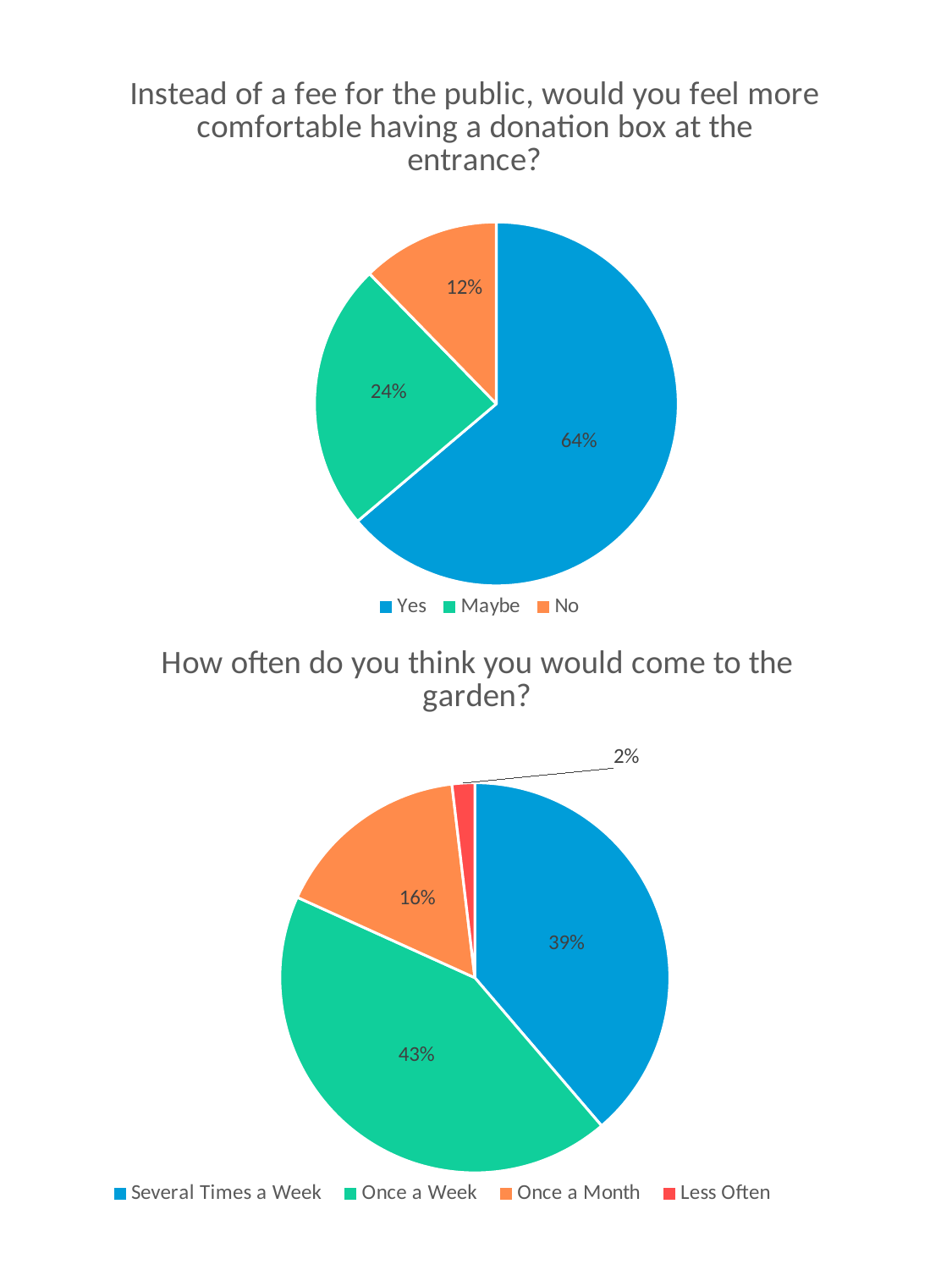
In the top chart about a donation box at the entrance, what is the difference between the Maybe and No shares? 12% In the bottom chart about how often people would come to the garden, what is the difference between the Once a Week and Several Times a Week shares? 4% In the top chart about a donation box at the entrance, what share of respondents answered Yes? 64% In the bottom chart about how often people would come to the garden, which is larger: Several Times a Week or Once a Month? Several Times a Week In the bottom chart about how often people would come to the garden, what share chose Once a Week? 43% In the top chart about a donation box at the entrance, which response has the largest slice? Yes In the top chart about a donation box at the entrance, how many categories does the legend list? 3 In the top chart about a donation box at the entrance, what share of respondents answered No? 12% In the bottom chart about how often people would come to the garden, how many categories does the legend list? 4 In the bottom chart about how often people would come to the garden, what share chose Less Often? 2% What kind of chart is the top chart about a donation box at the entrance? Pie chart In the bottom chart about how often people would come to the garden, which response has the smallest slice? Less Often